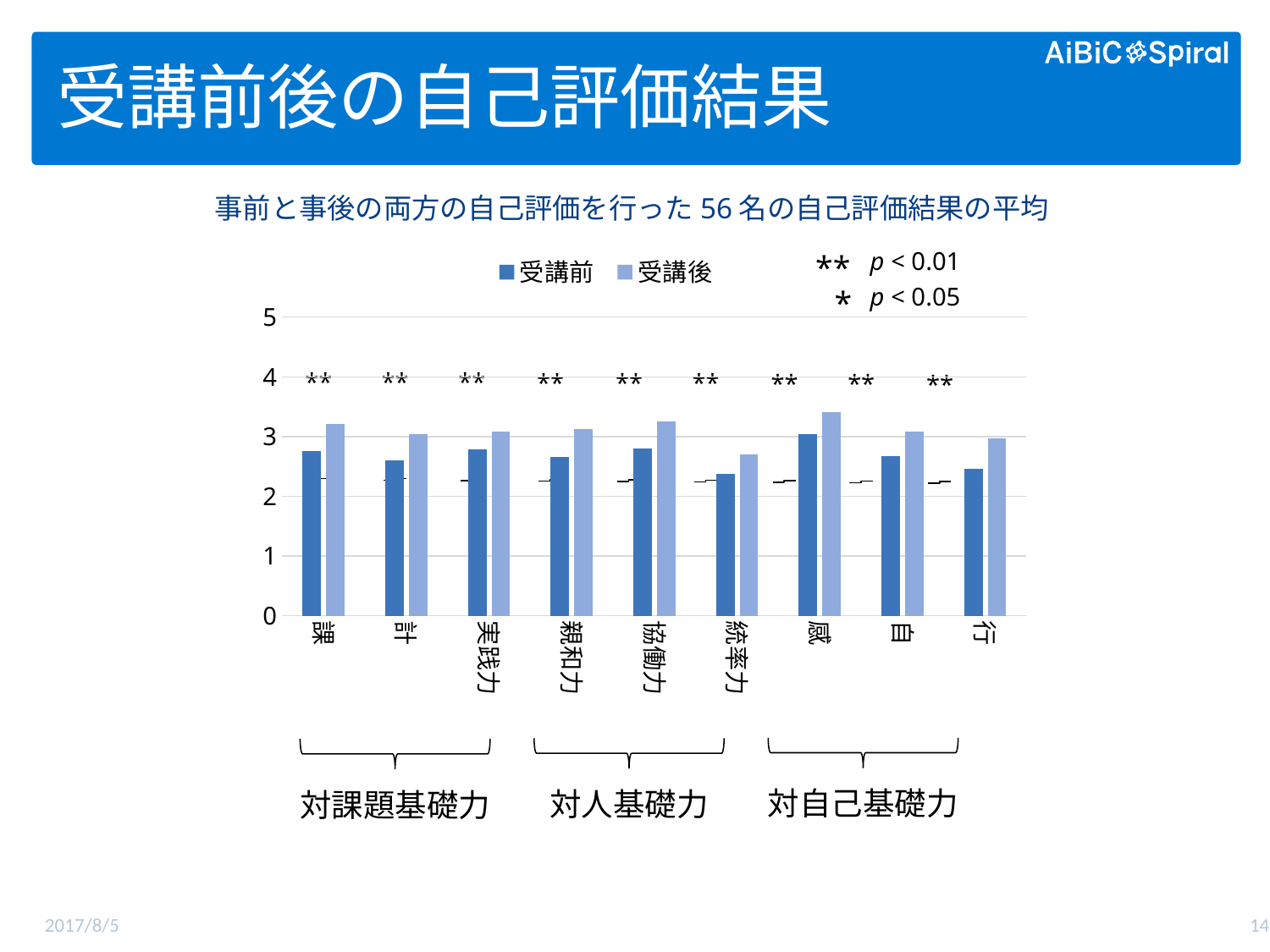
Which category has the lowest 受講前 value? 統率力 Which category has the highest 受講後 value? 感 Which category has the lowest 受講後 value? 統率力 For 協働力, which is larger: the 受講前 value or the 受講後 value? 受講後 How many groups (brackets) are the categories divided into below the x axis? 3 Is the 受講後 value for 感 greater or less than 3? greater Is the 受講前 value for 統率力 greater or less than 3? less What are the two series named in the legend? 受講前 and 受講後 What kind of chart is shown on the slide? bar chart How many categories are plotted along the x axis of the chart? 9 Is the 受講後 value for 統率力 greater or less than 3? less How many series does the chart's legend list? 2